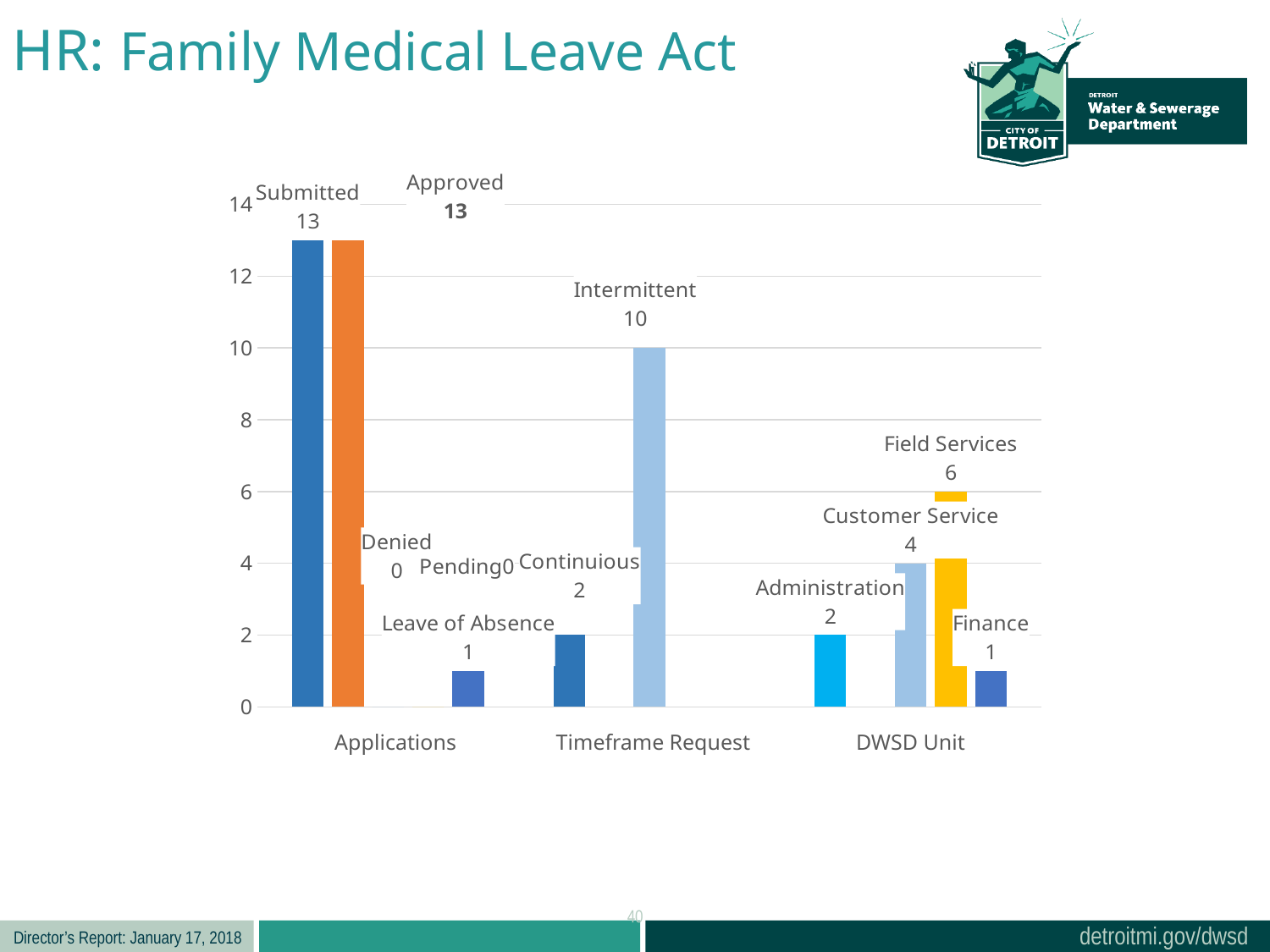
What is the value for Denied in the Applications group? 0 What is the value for Leave of Absence in the Applications group? 1 Which is larger, Customer Service or Administration in the DWSD Unit group? Customer Service What kind of chart is shown on the slide? Bar chart How many groups are shown on the x axis? 3 What is the value for Intermittent in the Timeframe Request group? 10 Which DWSD Unit has the lowest value? Finance Which DWSD Unit has the highest value? Field Services What is the difference between Intermittent and Continuious in the Timeframe Request group? 8 What is the value for Submitted in the Applications group? 13 What is the value for Field Services in the DWSD Unit group? 6 What is the difference between Field Services and Customer Service in the DWSD Unit group? 2